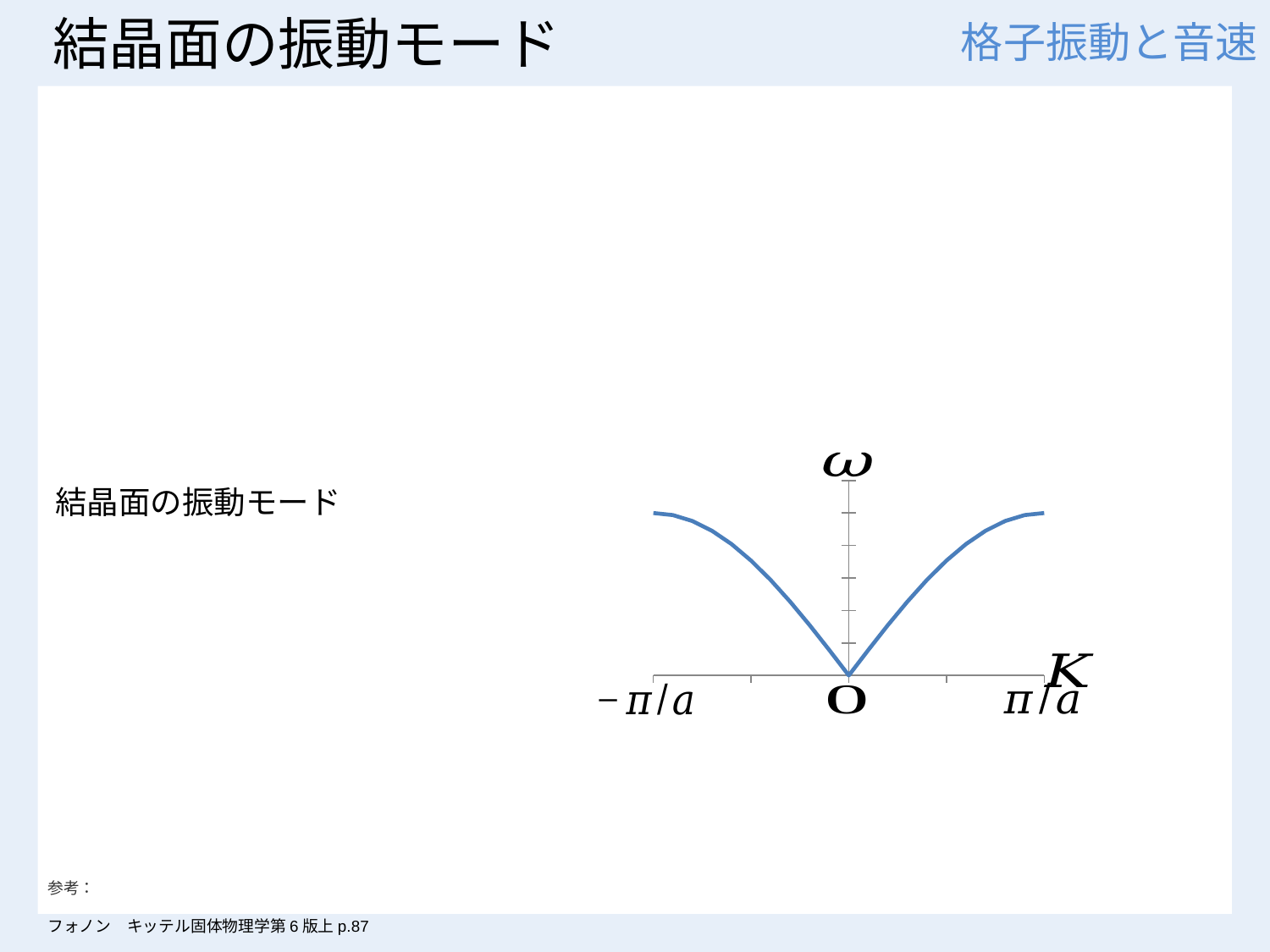
What is the label on the vertical axis of the chart? ω What is the leftmost tick label on the horizontal axis? -π/a What kind of chart is shown on the slide? line chart What is the label on the horizontal axis of the chart? K Does the curve rise or fall as K goes from -π/a to O? fall Does the curve rise or fall as K goes from O to π/a? rise Is the value of ω at K = π/a greater or less than the value at K = O? greater At which value of K does the curve reach its lowest point? O How many curves are plotted on the chart? 1